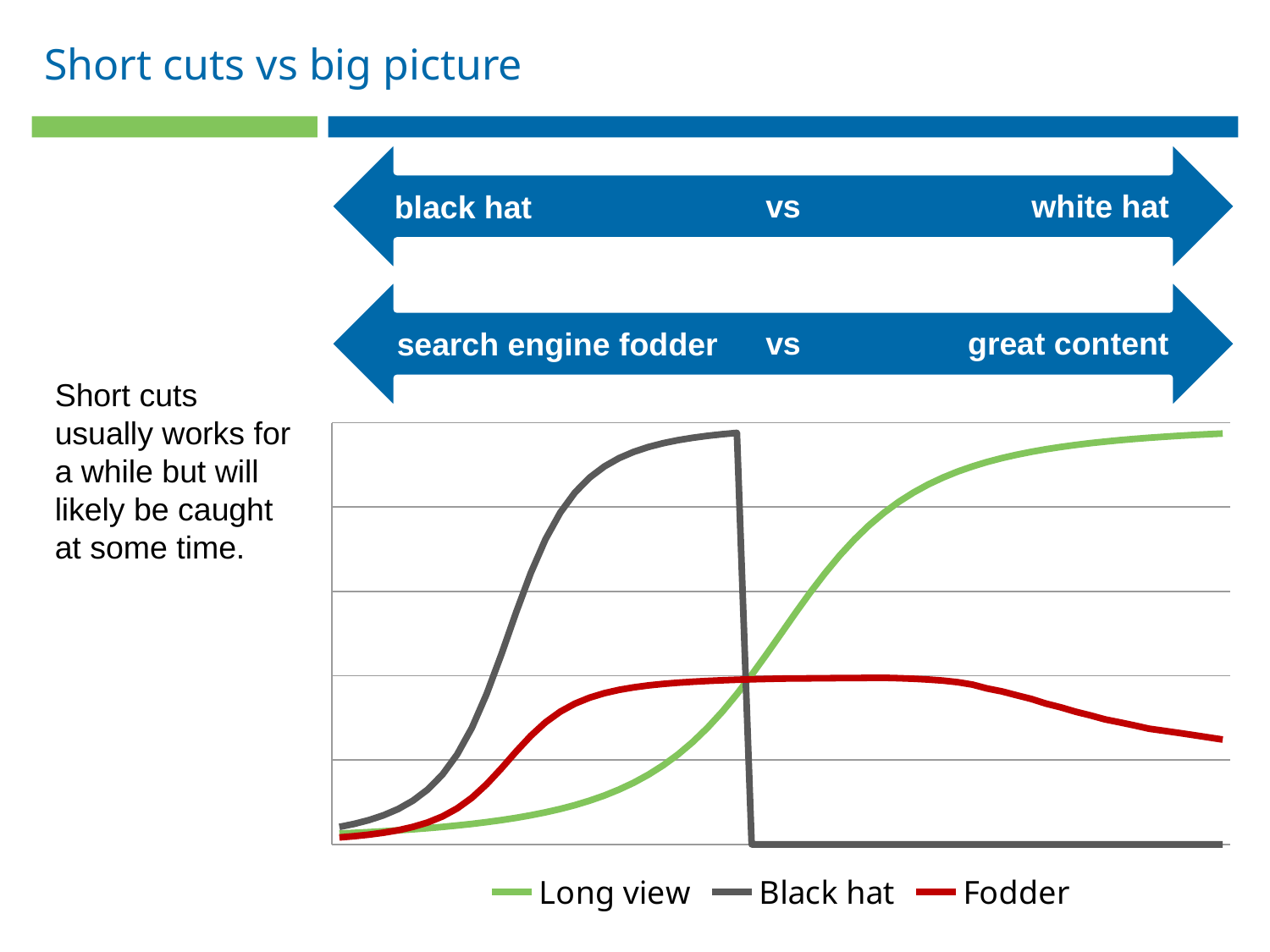
At the right edge of the chart, which is larger, the Long view series or the Fodder series? Long view What kind of chart is shown on the slide? line chart Which series reaches the highest point anywhere in the chart before dropping sharply? Black hat Near the left edge of the chart, which series is higher, Black hat or Long view? Black hat Which colour is used for the Long view series in the chart? green What are the three series named in the chart's legend? Long view, Black hat, Fodder Does the Fodder series rise or fall over the final third of the chart? fall Which series ends at the highest value at the right edge of the chart? Long view Does the Long view series rise or fall along the x axis? rise How many series does the chart's legend list? 3 Which series ends at the lowest value at the right edge of the chart? Black hat